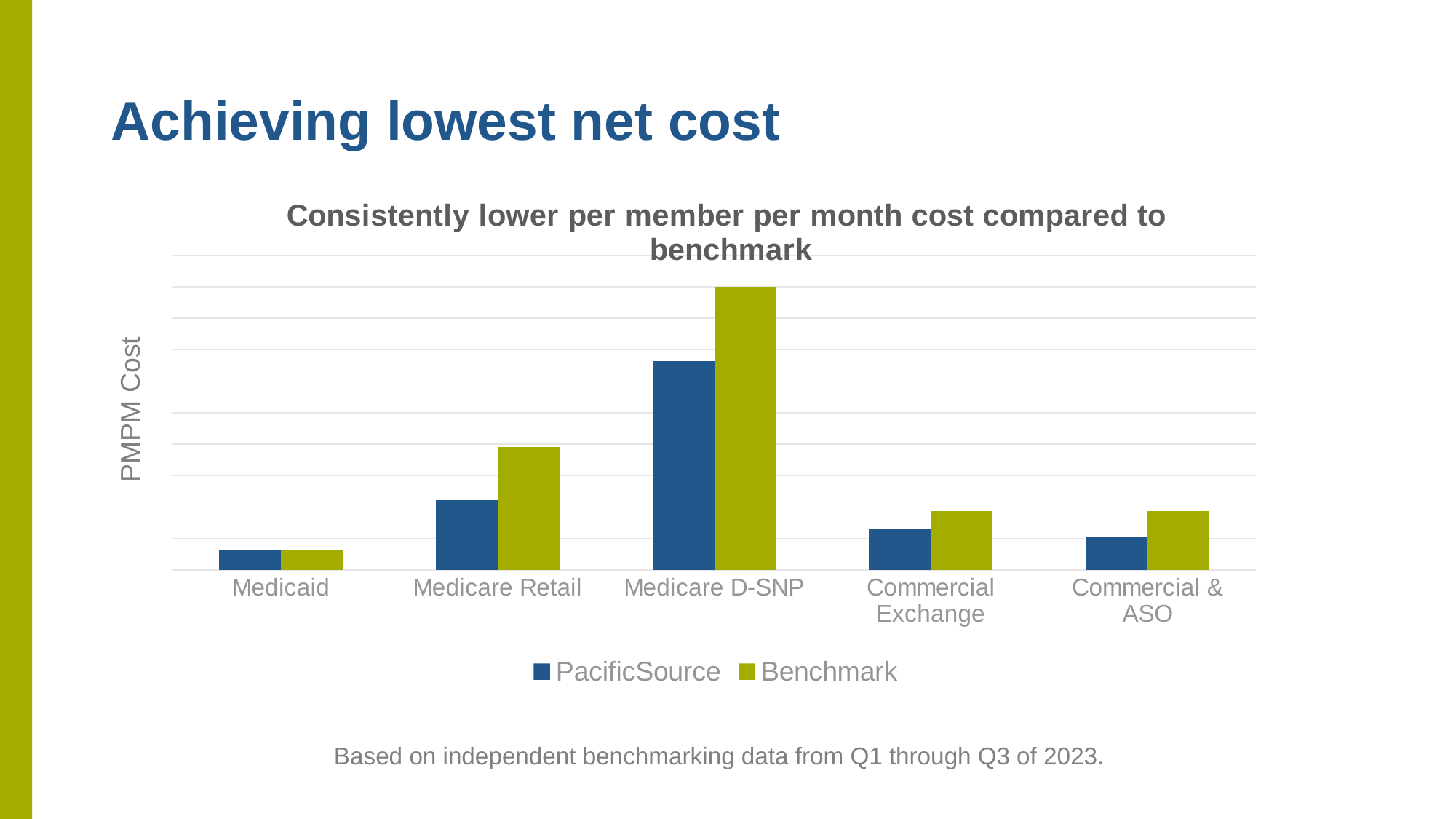
Which category has the highest PacificSource PMPM cost? Medicare D-SNP What is the title of the chart? Consistently lower per member per month cost compared to benchmark Which category has the highest Benchmark PMPM cost? Medicare D-SNP How many series does the legend list? 2 For Medicare D-SNP, which is larger: the PacificSource value or the Benchmark value? Benchmark What is the label on the y axis of the chart? PMPM Cost Which category has the lowest PacificSource PMPM cost? Medicaid What kind of chart is shown on the slide? bar chart How many categories are shown on the x axis? 5 For PacificSource, which is larger: Medicare Retail or Commercial Exchange? Medicare Retail Which category has the lowest Benchmark PMPM cost? Medicaid For Medicare Retail, which is larger: the PacificSource value or the Benchmark value? Benchmark